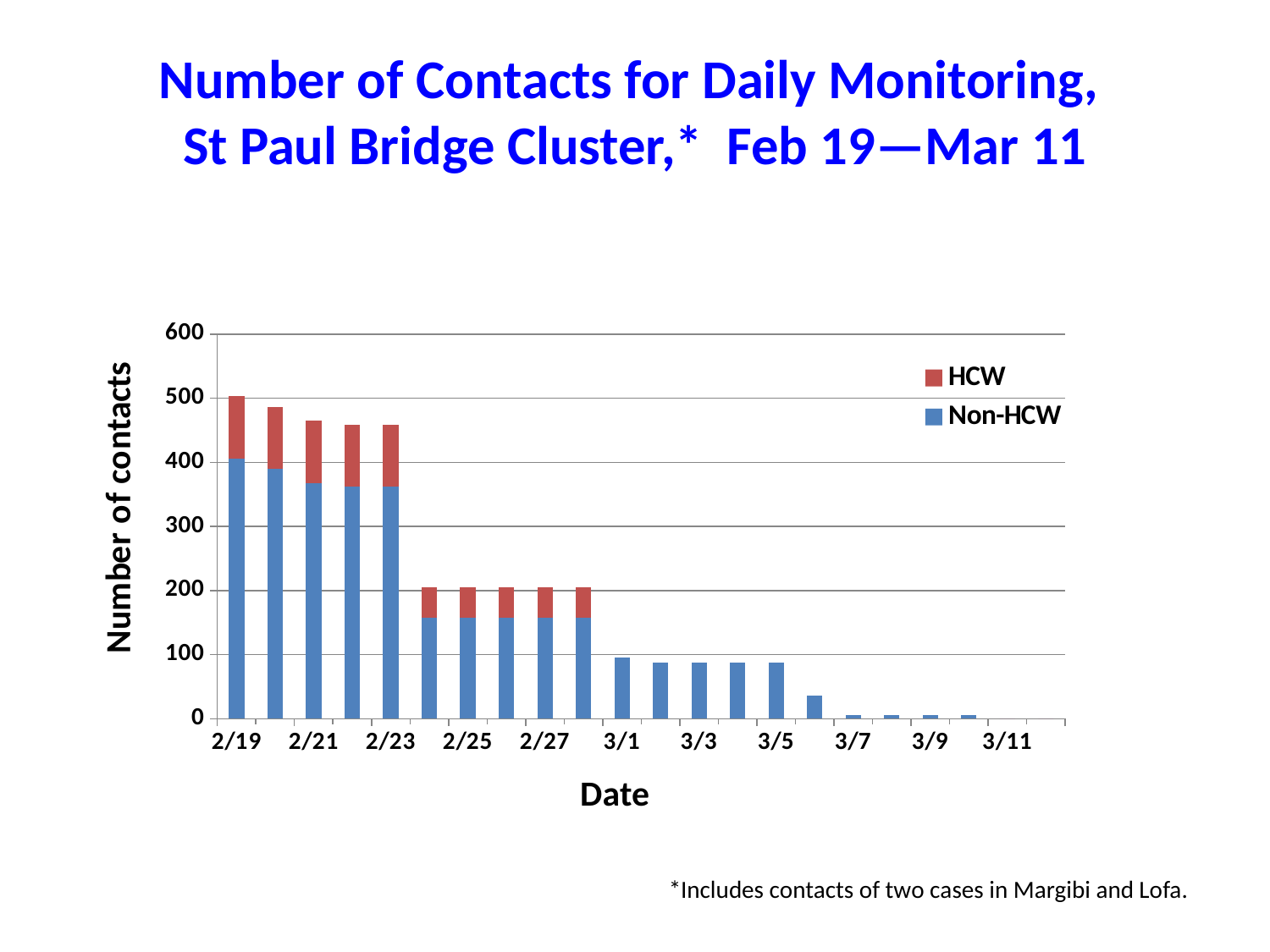
What is the label of the y axis? Number of contacts What are the two series named in the legend? HCW and Non-HCW Which colour represents the HCW series? Red Which date has more total contacts, 2/21 or 2/27? 2/21 Do the total contacts generally rise or fall from 2/19 to 3/11? Fall How many series does the legend list? 2 Is the number of contacts on 3/3 greater or less than 100? less What kind of chart is shown on the slide? Stacked bar chart On which date is the total number of contacts highest? 2/19